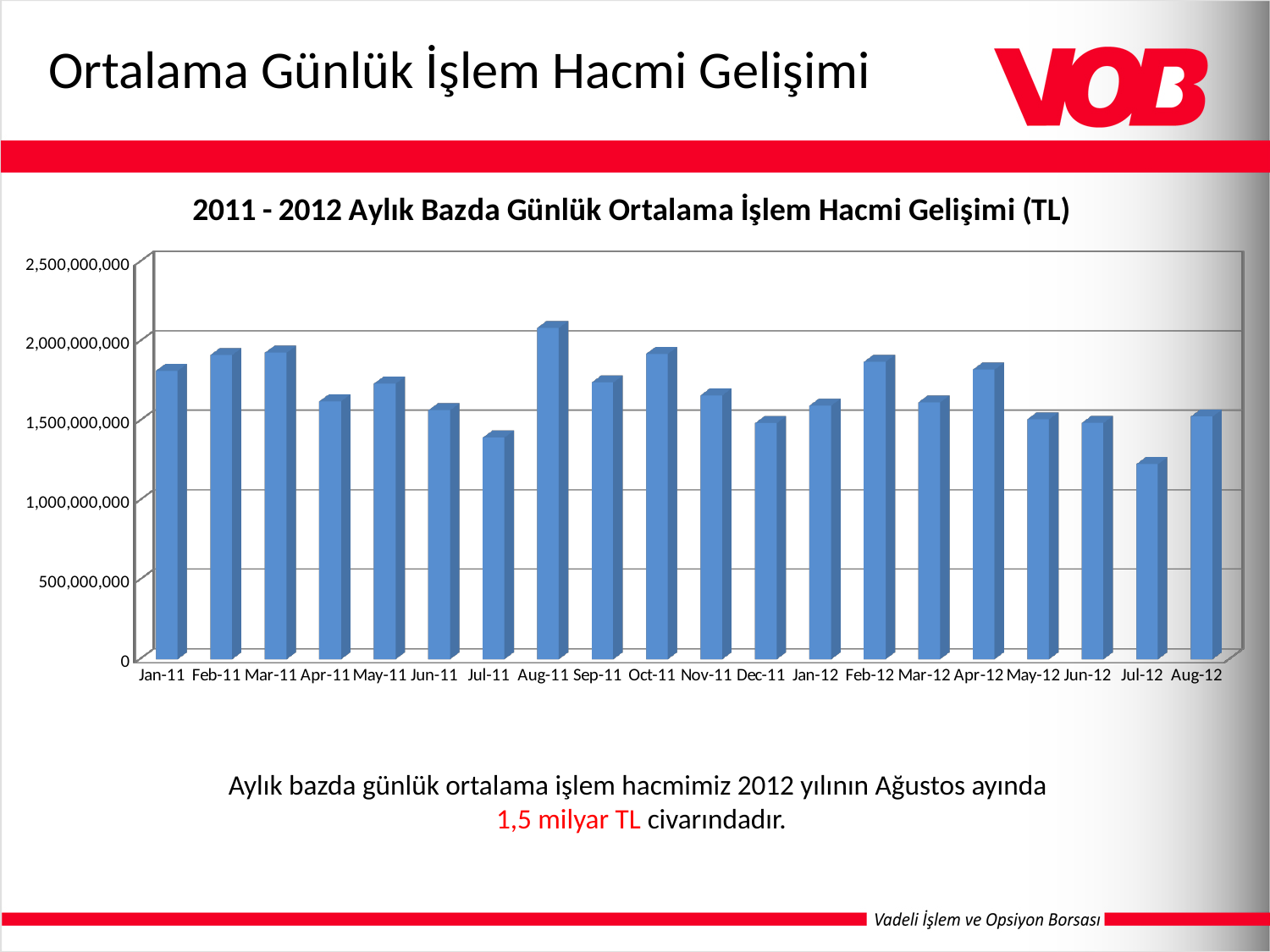
Do the values rise or fall from Apr-12 to Jul-12? fall Is the value for Aug-11 greater or less than 2,000,000,000? greater Which is larger, the value for Feb-12 or the value for Jul-12? Feb-12 What is the title of the chart? 2011 - 2012 Aylık Bazda Günlük Ortalama İşlem Hacmi Gelişimi (TL) Which is larger, the value for Mar-11 or the value for Jul-11? Mar-11 Is the value for Jul-12 greater or less than 1,500,000,000? less What kind of chart is shown on the slide? bar chart Which month has the highest average daily trading volume in the chart? Aug-11 Is the value for Jan-11 greater or less than 1,500,000,000? greater Which month has the lowest average daily trading volume in the chart? Jul-12 How many months are plotted on the x axis of the chart? 20